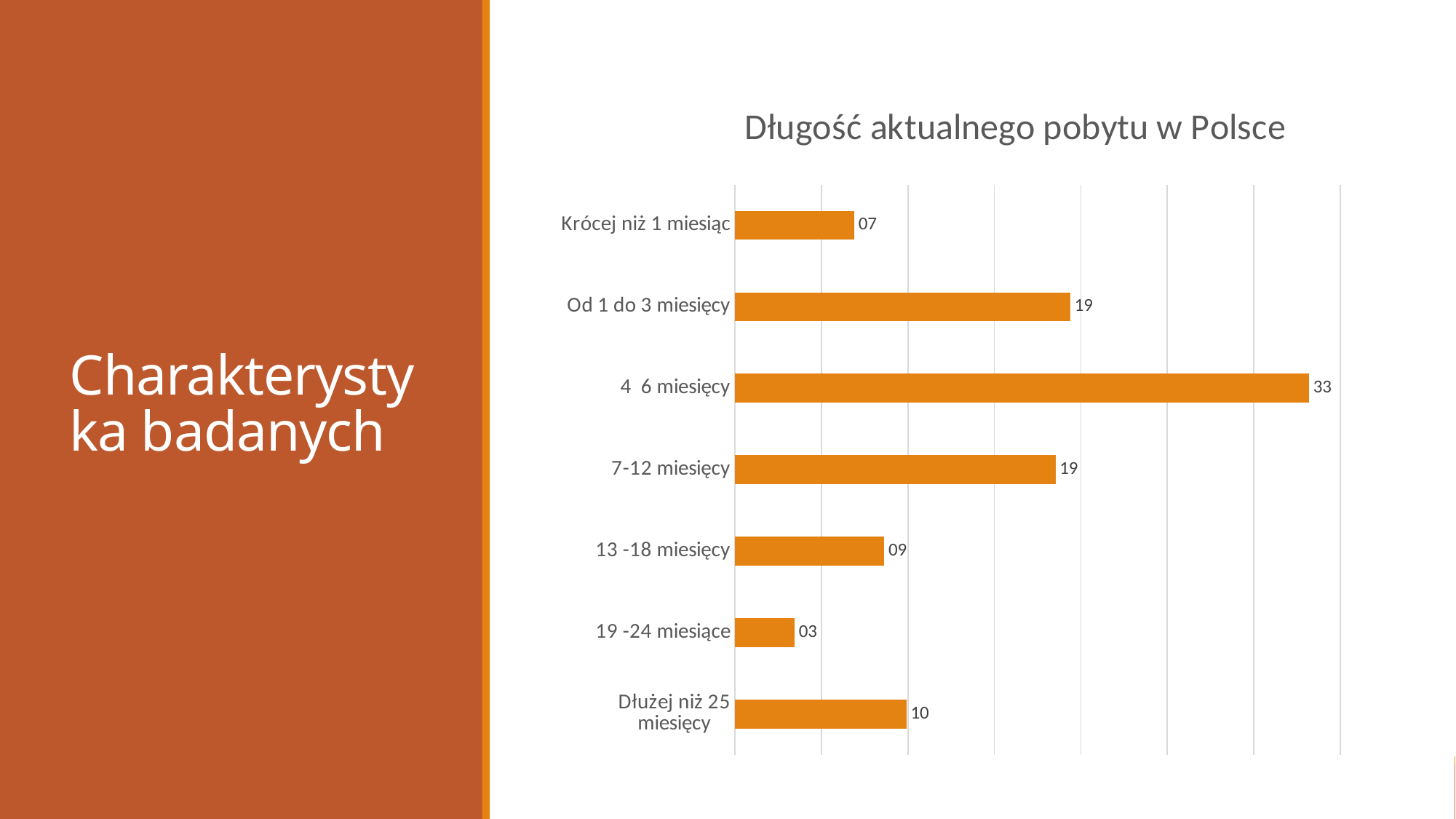
What is the value for "Krócej niż 1 miesiąc"? 07 What is the value for "Dłużej niż 25 miesięcy"? 10 What is the value for "13 -18 miesięcy"? 09 What kind of chart is shown on the slide? Bar chart Which is larger, the value for "13 -18 miesięcy" or the value for "Dłużej niż 25 miesięcy"? Dłużej niż 25 miesięcy What is the difference between the values for "4 6 miesięcy" and "Od 1 do 3 miesięcy"? 14 How many categories are shown in the chart? 7 Which category has the lowest value? 19 -24 miesiące What is the value for "4 6 miesięcy"? 33 What is the title of the chart? Długość aktualnego pobytu w Polsce What is the difference between the values for "Dłużej niż 25 miesięcy" and "19 -24 miesiące"? 7 Which category has the highest value? 4 6 miesięcy